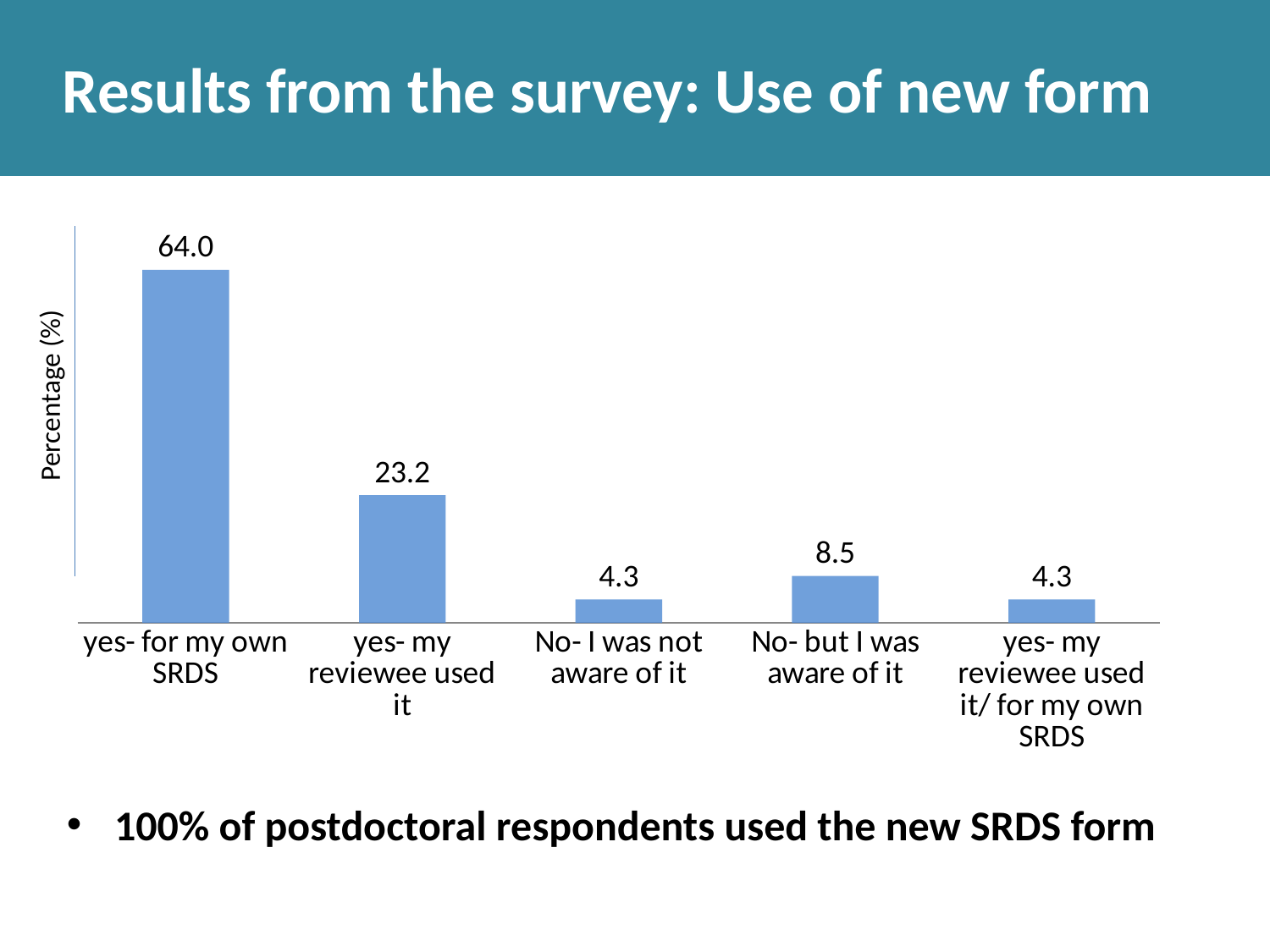
What is the label of the vertical axis? Percentage (%) What is the value for "No- but I was aware of it"? 8.5 What is the value for "yes- for my own SRDS"? 64.0 What is the difference between the values for "yes- for my own SRDS" and "yes- my reviewee used it"? 40.8 Which category has the highest value? yes- for my own SRDS Which is larger, the value for "yes- my reviewee used it" or the value for "No- but I was aware of it"? yes- my reviewee used it What is the difference between the values for "No- but I was aware of it" and "No- I was not aware of it"? 4.2 What is the value for "yes- my reviewee used it/ for my own SRDS"? 4.3 What is the value for "No- I was not aware of it"? 4.3 How many categories are shown on the x axis? 5 What is the value for "yes- my reviewee used it"? 23.2 What kind of chart is shown on the slide? bar chart